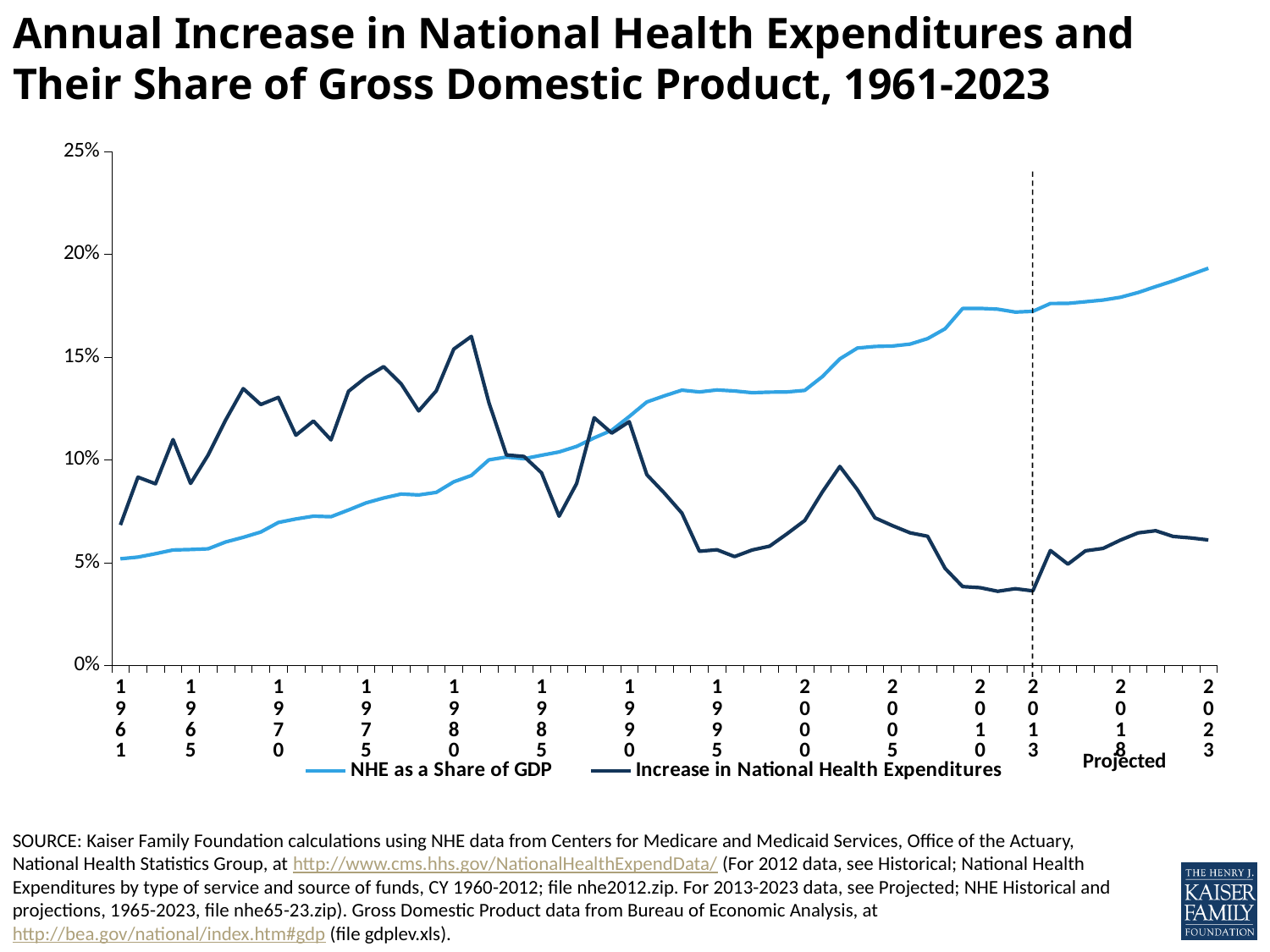
Is the value for NHE as a Share of GDP in 2023 greater or less than 15%? greater What are the two series named in the legend? NHE as a Share of GDP; Increase in National Health Expenditures Is the value for NHE as a Share of GDP in 2023 greater or less than 20%? less How many series does the legend list? 2 Is the value for NHE as a Share of GDP in 1980 greater or less than 10%? less What does the dashed vertical line near 2013 mark? Projected In 2023, which series has the higher value: NHE as a Share of GDP or Increase in National Health Expenditures? NHE as a Share of GDP Does the NHE as a Share of GDP line generally rise or fall from 1961 to 2023? Rise What type of chart is shown on the slide? Line chart Does the Increase in National Health Expenditures line generally rise or fall from 1980 to 2013? Fall